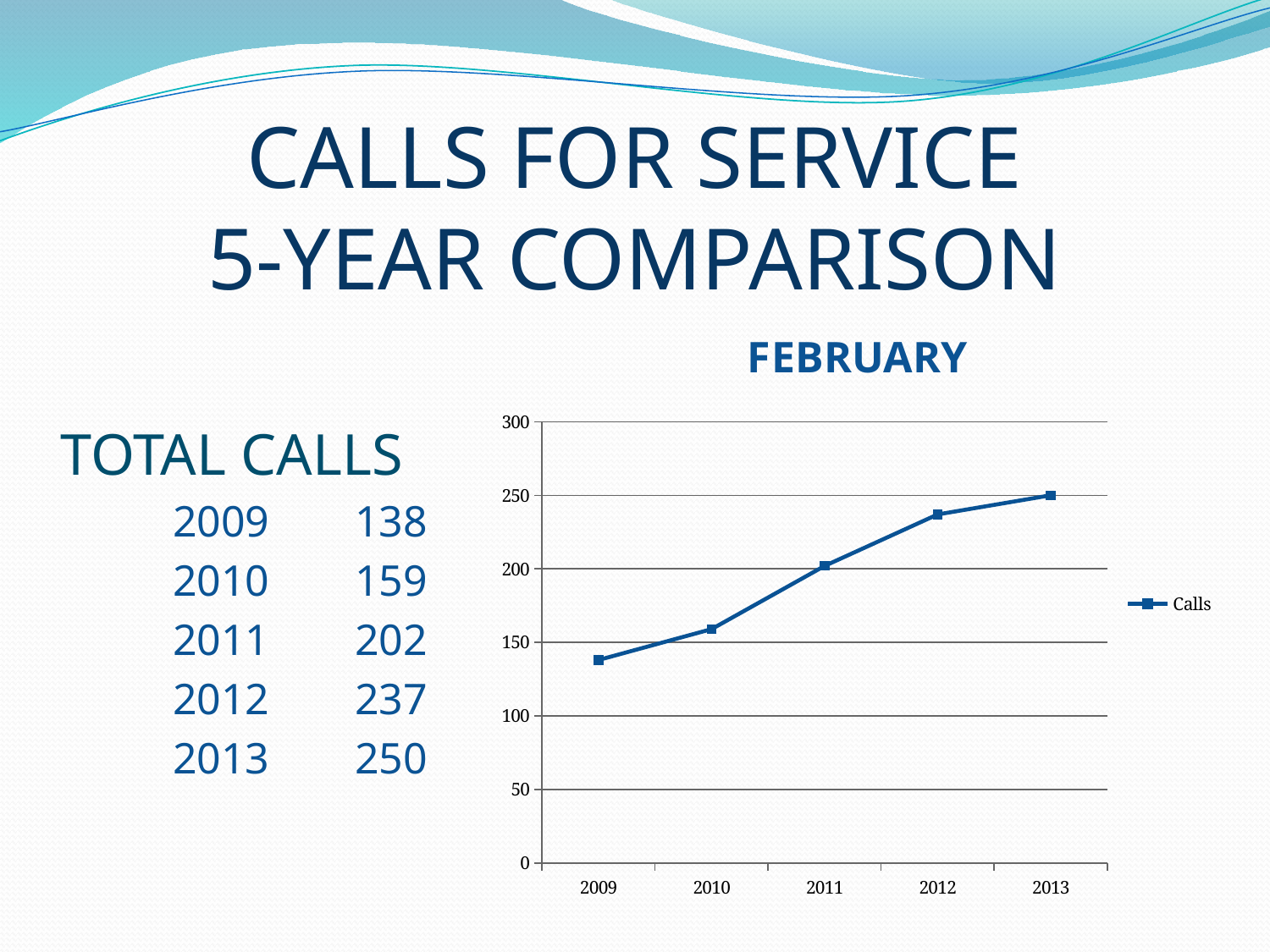
Do the calls rise or fall from 2009 to 2013? rise What is the title of the chart? FEBRUARY How many series does the legend list? 1 Which year has more calls, 2010 or 2012? 2012 Which year has the highest number of calls? 2013 What is the number of calls for 2011? 202 Is the value for 2012 greater or less than 200? greater Which year has the lowest number of calls? 2009 What is the number of calls for 2009? 138 How many years are plotted on the x axis of the chart? 5 What type of chart is shown on the slide? line chart What is the difference in calls between 2013 and 2009? 112